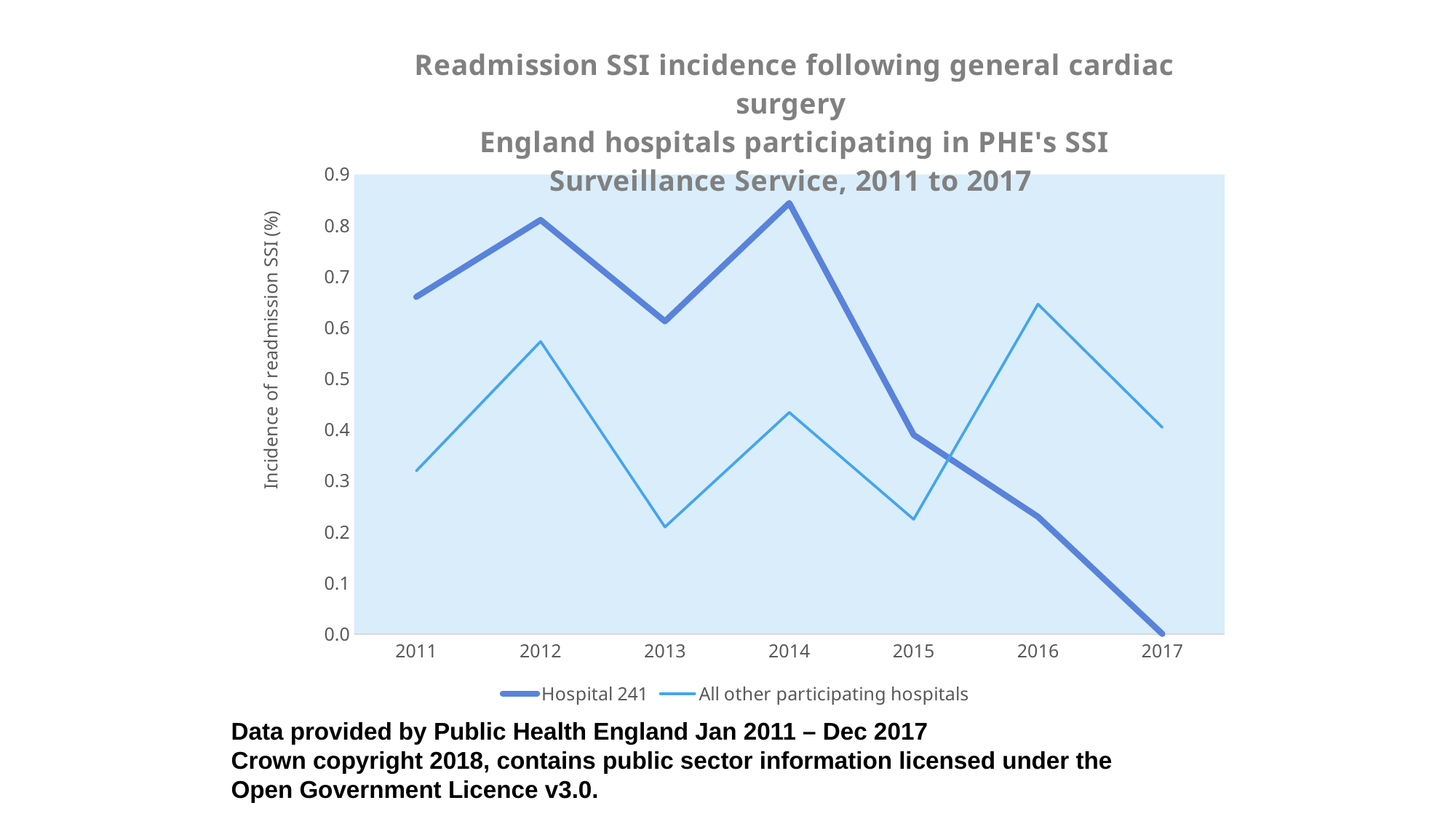
What kind of chart is shown on the slide? line chart In which year is the value for All other participating hospitals highest? 2016 Does the value for Hospital 241 rise or fall from 2014 to 2017? fall What is the label on the y axis? Incidence of readmission SSI (%) In which year is the value for Hospital 241 lowest? 2017 Is the value for All other participating hospitals in 2013 greater or less than 0.3? less Is the value for Hospital 241 in 2014 greater or less than 0.8? greater In which year is the value for Hospital 241 highest? 2014 How many series does the legend list? 2 What is the value for Hospital 241 in 2017? 0.0 In 2016, which series has the larger value, Hospital 241 or All other participating hospitals? All other participating hospitals How many years are plotted along the x axis? 7